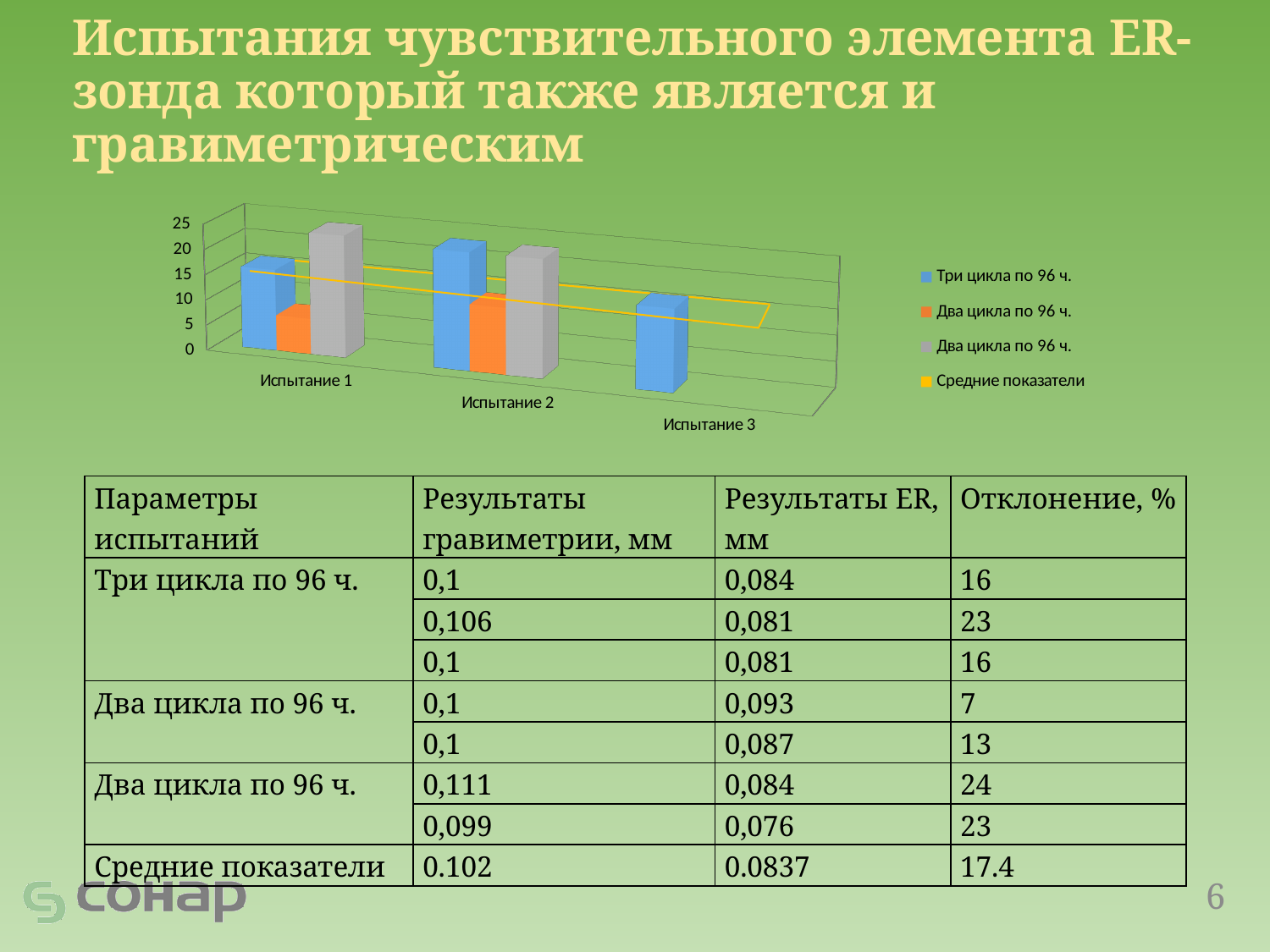
Is the value of the blue bar for Испытание 2 greater or less than 15? greater Is the value of the blue bar for Испытание 3 greater or less than 20? less Which is larger: the blue bar for Испытание 2 or the blue bar for Испытание 3? Испытание 2 What is the last entry in the chart legend? Средние показатели Is the value of the grey bar for Испытание 1 greater or less than 15? greater What kind of chart is shown on the slide? bar chart What are the category labels along the x axis of the chart? Испытание 1, Испытание 2, Испытание 3 What is the highest value shown on the vertical axis of the chart? 25 How many series does the chart legend list? 4 How many categories are shown on the x axis of the chart? 3 For Испытание 1, which is larger: the grey bar or the orange bar? the grey bar